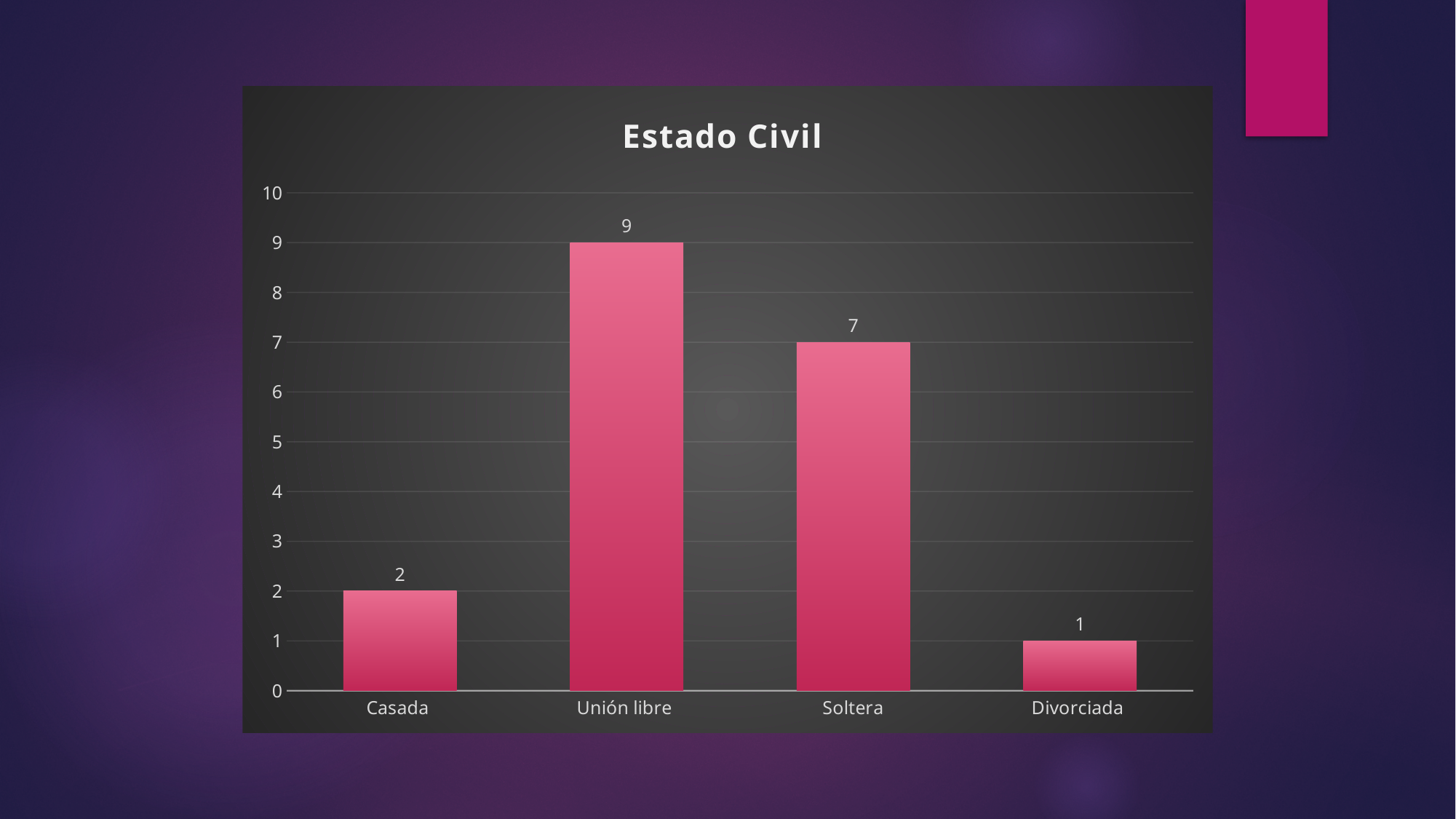
How many categories are shown on the x axis? 4 Which category has the lowest value? Divorciada What is the value for Unión libre? 9 What is the value for Casada? 2 Which is larger, the value for Casada or the value for Divorciada? Casada Is the value for Soltera greater or less than 5? greater Which category has the highest value? Unión libre What kind of chart is shown on the slide? Bar chart What is the value for Divorciada? 1 What is the difference between the values for Unión libre and Soltera? 2 What is the value for Soltera? 7 What is the title of the chart? Estado Civil